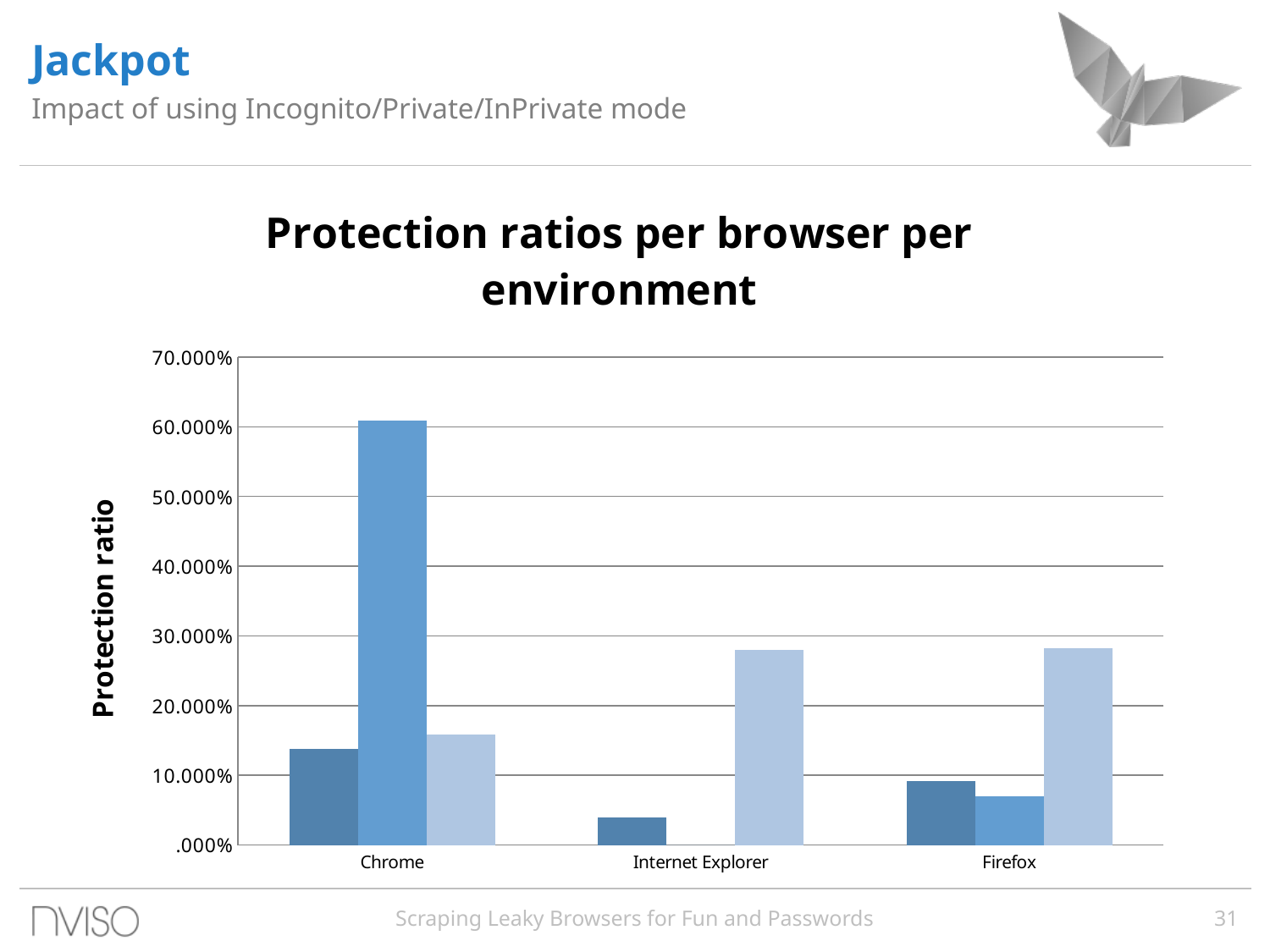
What kind of chart is shown on the slide? bar chart What is the title of the chart? Protection ratios per browser per environment Is the first (dark blue) bar for Internet Explorer greater or less than 10.000%? less Which browser has the lowest first (dark blue) bar? Internet Explorer Which is larger for Firefox: the first (dark blue) bar or the third (light blue) bar? the third (light blue) bar What is the label on the vertical axis of the chart? Protection ratio Is the third (light blue) bar for Firefox greater or less than 30.000%? less How many browsers are shown on the x axis of the chart? 3 Is the tallest bar for Chrome greater or less than 60.000%? greater Which browser has the tallest bar in the chart? Chrome